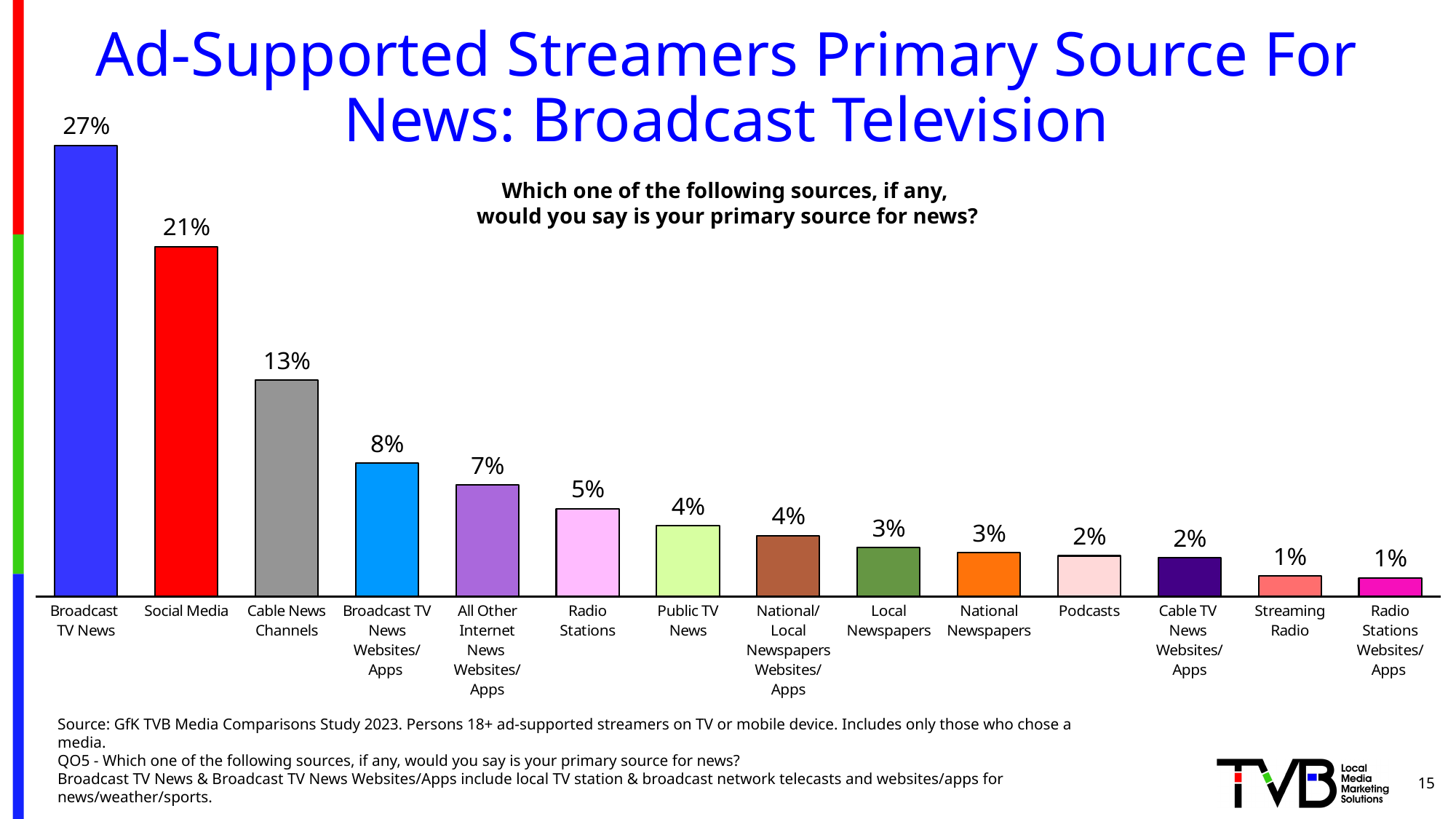
What is the value shown for Radio Stations? 5% What is the value shown for Streaming Radio? 1% Do the values rise or fall moving from left to right across the chart? Fall Which is larger, the value for Public TV News or the value for Podcasts? Public TV News What is the difference between the values for Broadcast TV News and Social Media? 6% Which source has the highest percentage? Broadcast TV News What kind of chart is shown on the slide? Bar chart How many sources (bars) are shown in the chart? 14 What is the value shown for Social Media? 21% What percentage of ad-supported streamers say Broadcast TV News is their primary source for news? 27% What is the value shown for Cable News Channels? 13% What is the difference between the values for Cable News Channels and Broadcast TV News Websites/Apps? 5%